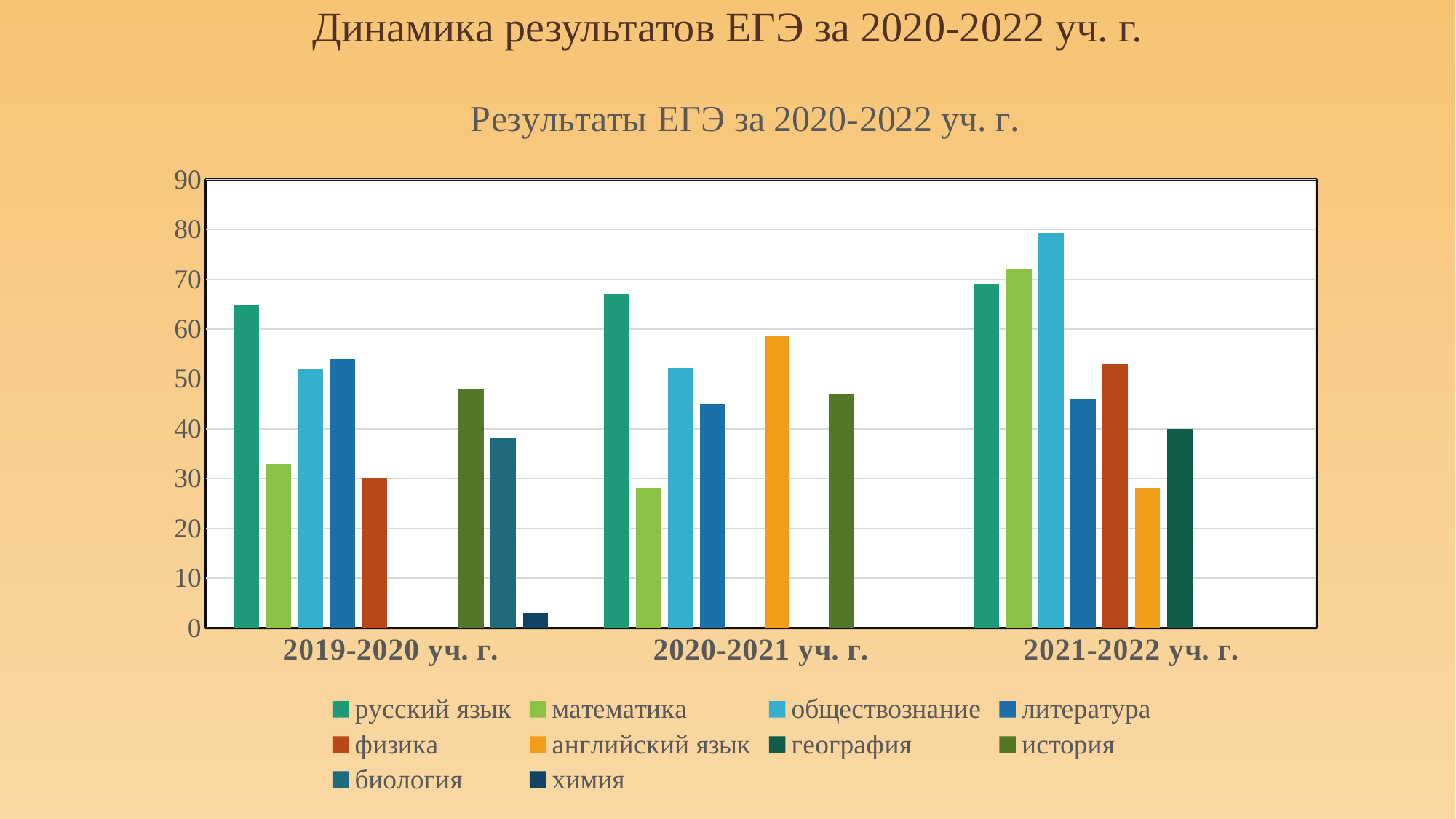
Which subject has the highest value in 2021-2022 уч. г.? обществознание How many academic-year categories are shown on the x axis? 3 What is the title of the chart? Результаты ЕГЭ за 2020-2022 уч. г. How many series does the legend list? 10 Does the value for русский язык rise or fall from 2019-2020 уч. г. to 2021-2022 уч. г.? rises Which is larger: the value for математика in 2019-2020 уч. г. or in 2021-2022 уч. г.? 2021-2022 уч. г. Is the value for русский язык in 2019-2020 уч. г. greater or less than 60? greater Which subject has the lowest value in 2019-2020 уч. г.? химия Is the value for химия in 2019-2020 уч. г. greater or less than 10? less Is the value for английский язык in 2020-2021 уч. г. greater or less than 50? greater What kind of chart is shown on the slide? bar chart